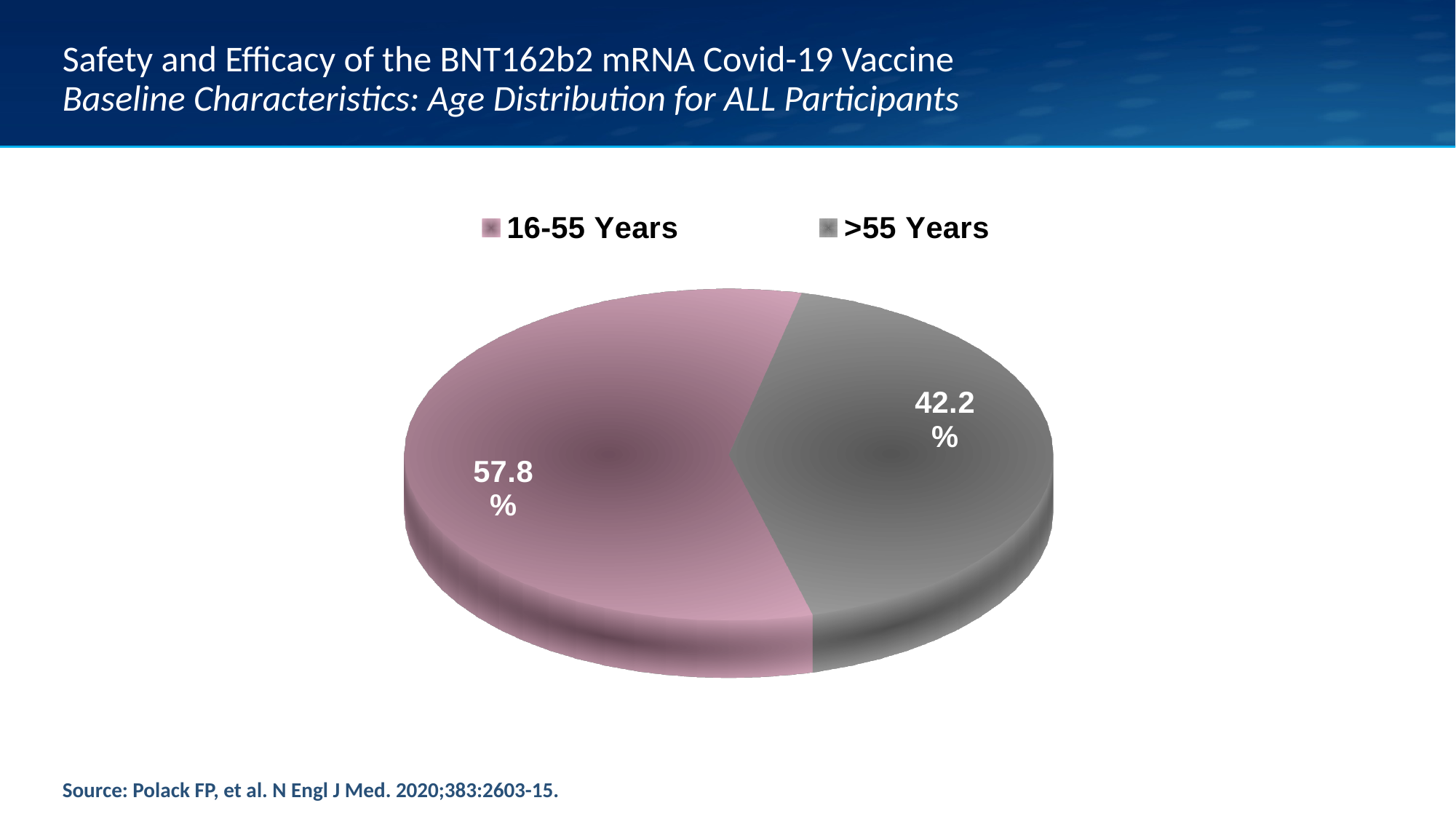
How many age groups are shown in the pie chart? 2 Which colour represents the >55 Years group? Grey What is the total of the two slices shown? 100% Which age group has the largest share of participants? 16-55 Years Which age group has the smallest share of participants? >55 Years What share of participants are in the >55 Years group? 42.2% What kind of chart is shown on the slide? Pie chart How many entries does the legend list? 2 What share of participants are in the 16-55 Years group? 57.8% Is the share for >55 Years greater or less than 50%? less Which group is larger, 16-55 Years or >55 Years? 16-55 Years What is the difference in percentage points between the 16-55 Years and >55 Years groups? 15.6